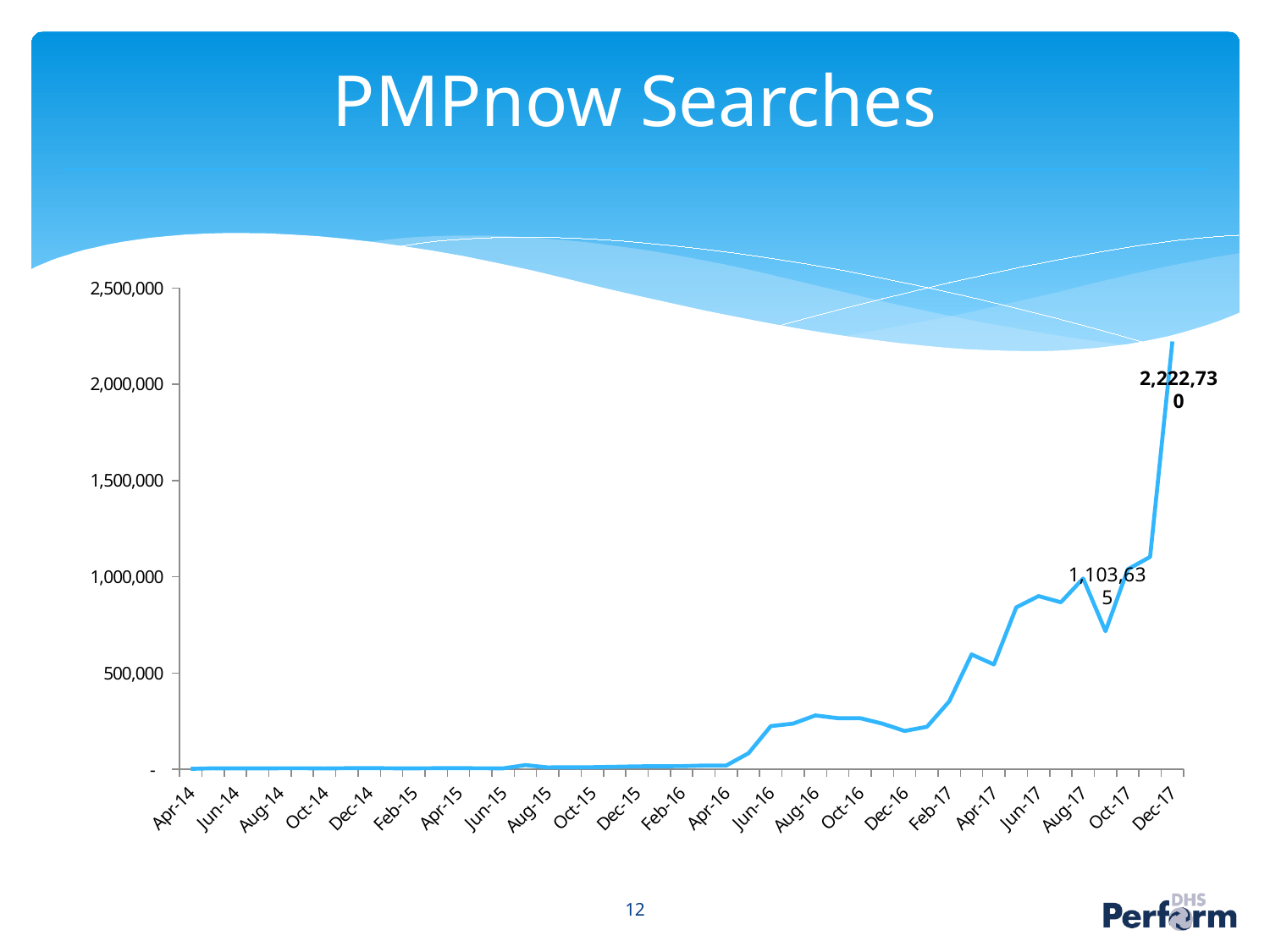
What is the difference between the two labelled values, 2,222,730 and 1,103,635? 1,119,095 Is the value for Feb-17 greater or less than 500,000? less Is the value for Jun-16 greater or less than 500,000? less What is the highest value labelled on the chart? 2,222,730 Which is larger, the value for Dec-17 or the value for Jun-16? Dec-17 What is the highest value shown on the y axis? 2,500,000 Do the values generally rise or fall from Apr-14 to Dec-17? rise What is the title of the chart? PMPnow Searches What value is labelled at the final point, Dec-17? 2,222,730 What kind of chart is shown on the slide? line chart